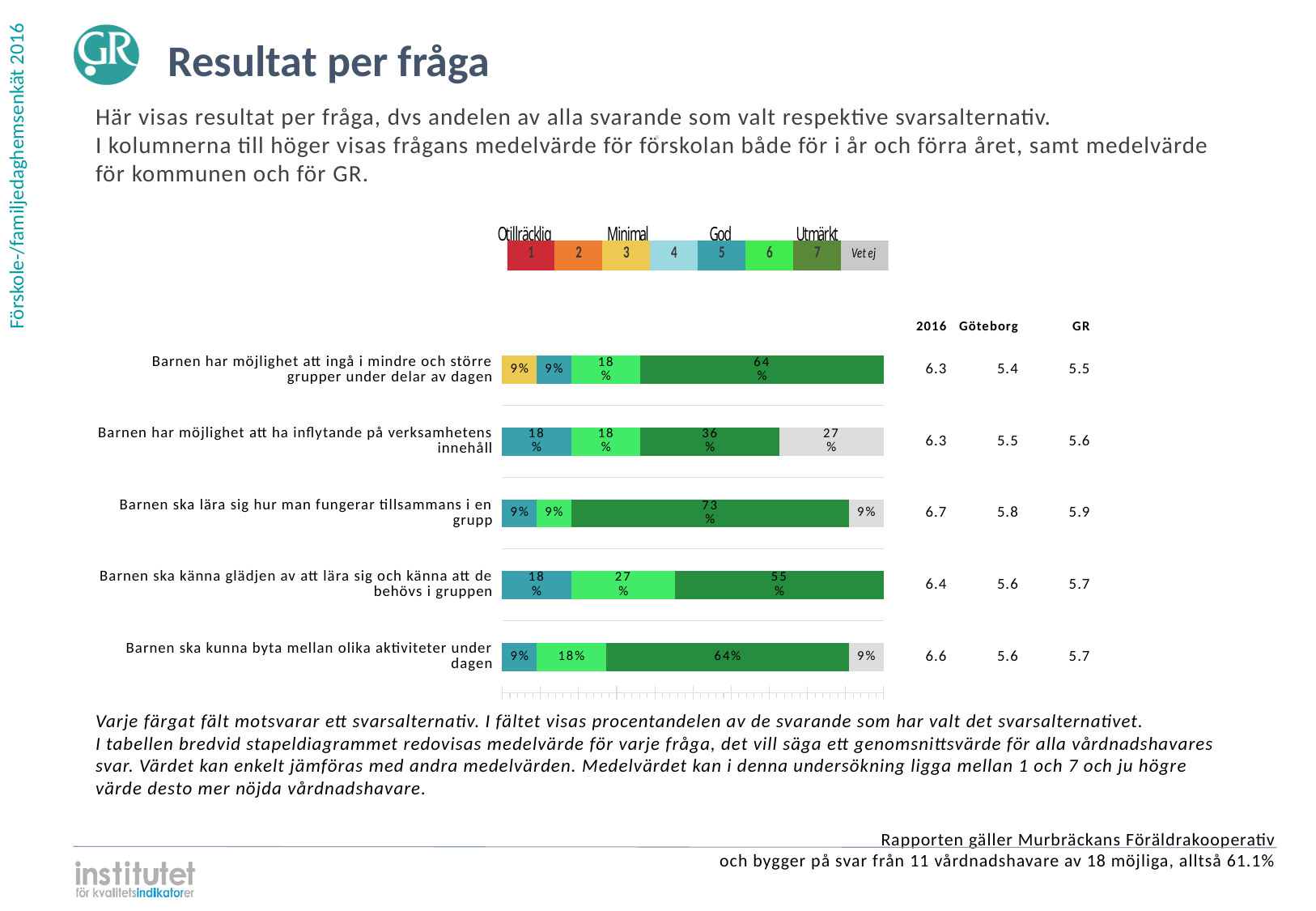
Which question has the highest 2016 mean value? Barnen ska lära sig hur man fungerar tillsammans i en grupp What is the 2016 mean value for "Barnen ska kunna byta mellan olika aktiviteter under dagen"? 6.6 How many questions (categories) are plotted in the bar chart? 5 What is the combined share of answers 6 and 7 for "Barnen ska känna glädjen av att lära sig och känna att de behövs i gruppen"? 82% What percentage of respondents chose answer 7 (dark green) for "Barnen ska lära sig hur man fungerar tillsammans i en grupp"? 73% Which question has the largest share of respondents choosing answer 7 (dark green)? Barnen ska lära sig hur man fungerar tillsammans i en grupp How many entries does the colour legend above the chart list? 8 What is the Göteborg mean value for "Barnen ska lära sig hur man fungerar tillsammans i en grupp"? 5.8 Which is larger for "Barnen ska känna glädjen av att lära sig och känna att de behövs i gruppen": the share choosing answer 6 (light green) or answer 5 (teal)? Answer 6 (27%) What is the difference between the 2016 mean and the GR mean for "Barnen har möjlighet att ingå i mindre och större grupper under delar av dagen"? 0.8 What kind of chart is shown on the slide? Stacked bar chart What percentage chose "Vet ej" for "Barnen har möjlighet att ha inflytande på verksamhetens innehåll"? 27%